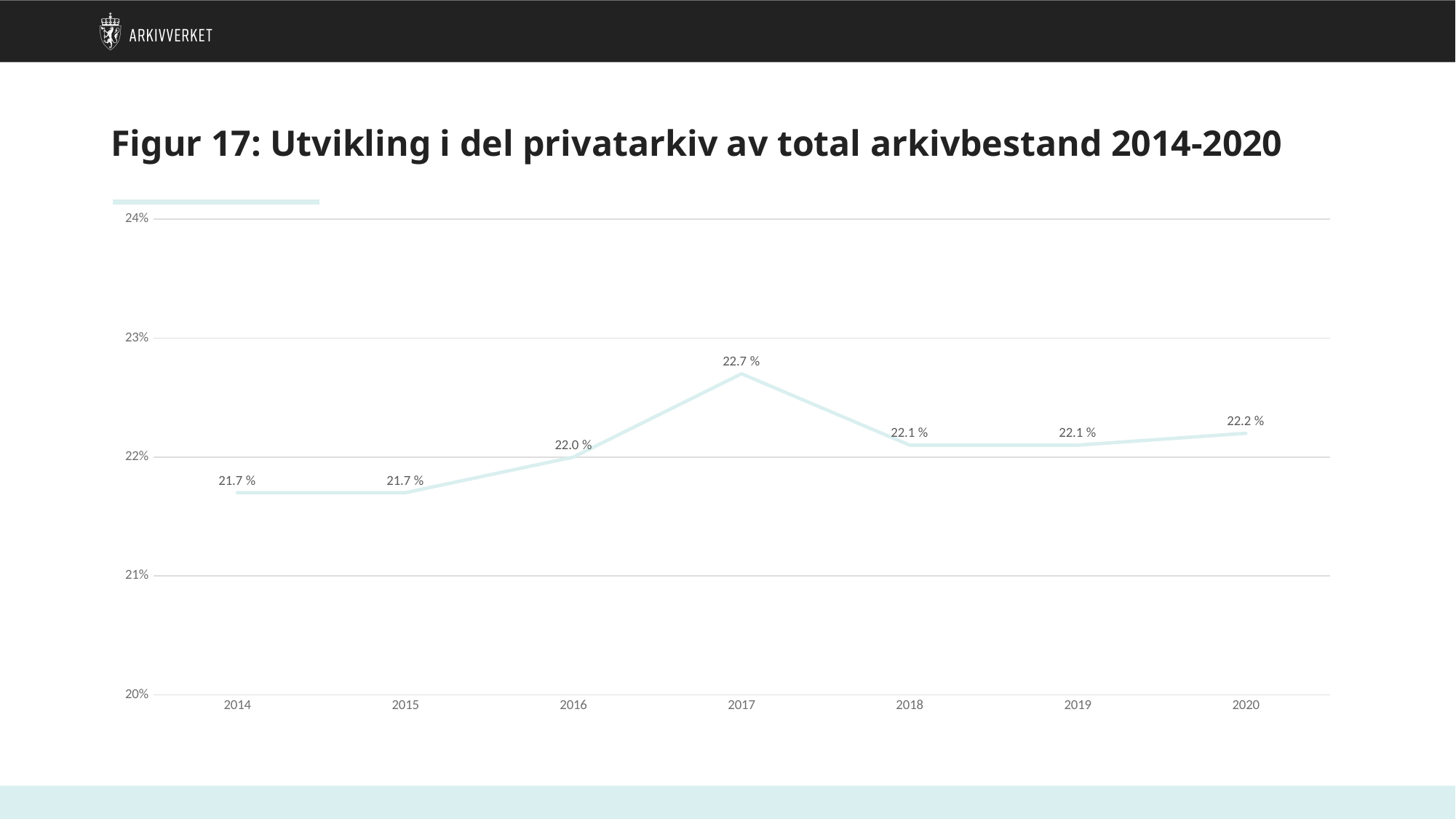
Which is larger, the value for 2016 or the value for 2020? 2020 How many years are plotted on the x axis? 7 What is the difference between the values for 2017 and 2018? 0.6 % What kind of chart is shown on the slide? line chart Does the value rise or fall from 2017 to 2018? fall What is the difference between the values for 2020 and 2014? 0.5 % What is the value for 2016? 22.0 % What is the value for 2017? 22.7 % What is the value for 2020? 22.2 % What is the value for 2014? 21.7 % Is the value for 2017 greater or less than 23%? less Which year has the highest value? 2017